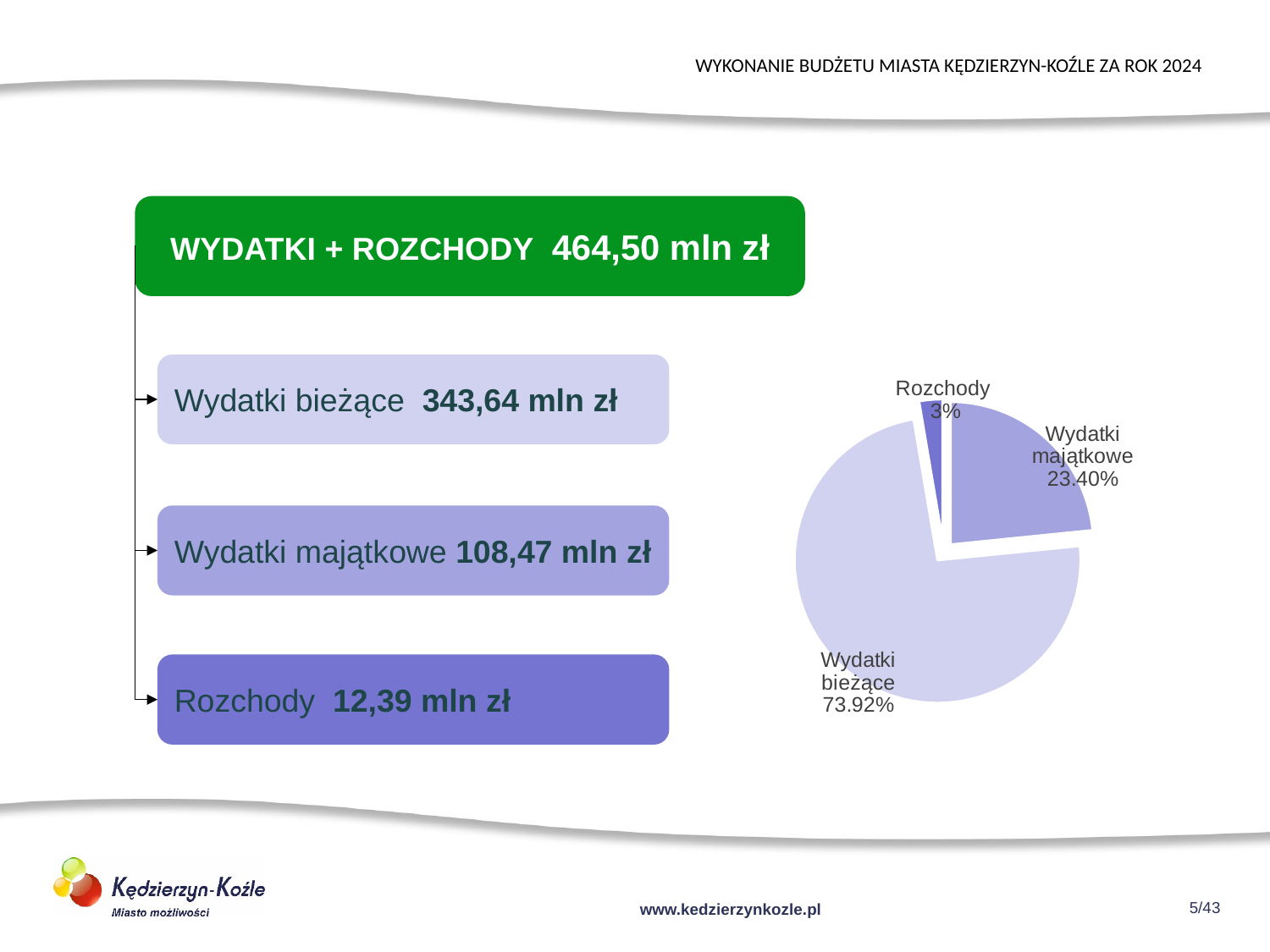
What amount in mln zł does the slide give for Wydatki majątkowe? 108,47 mln zł Which slice of the pie chart is the largest? Wydatki bieżące What percentage does the pie chart show for Wydatki majątkowe? 23.40% What percentage does the pie chart show for Wydatki bieżące? 73.92% By how many percentage points does the Wydatki majątkowe share exceed the Rozchody share in the pie chart? 20.40 What percentage does the pie chart show for Rozchody? 3% Which is larger in the pie chart, Wydatki majątkowe or Rozchody? Wydatki majątkowe What total amount does the green header box give for WYDATKI + ROZCHODY? 464,50 mln zł What kind of chart is shown on the slide? pie chart Which slice of the pie chart is the smallest? Rozchody By how many percentage points does the Wydatki bieżące share exceed the Wydatki majątkowe share in the pie chart? 50.52 How many slices does the pie chart have? 3